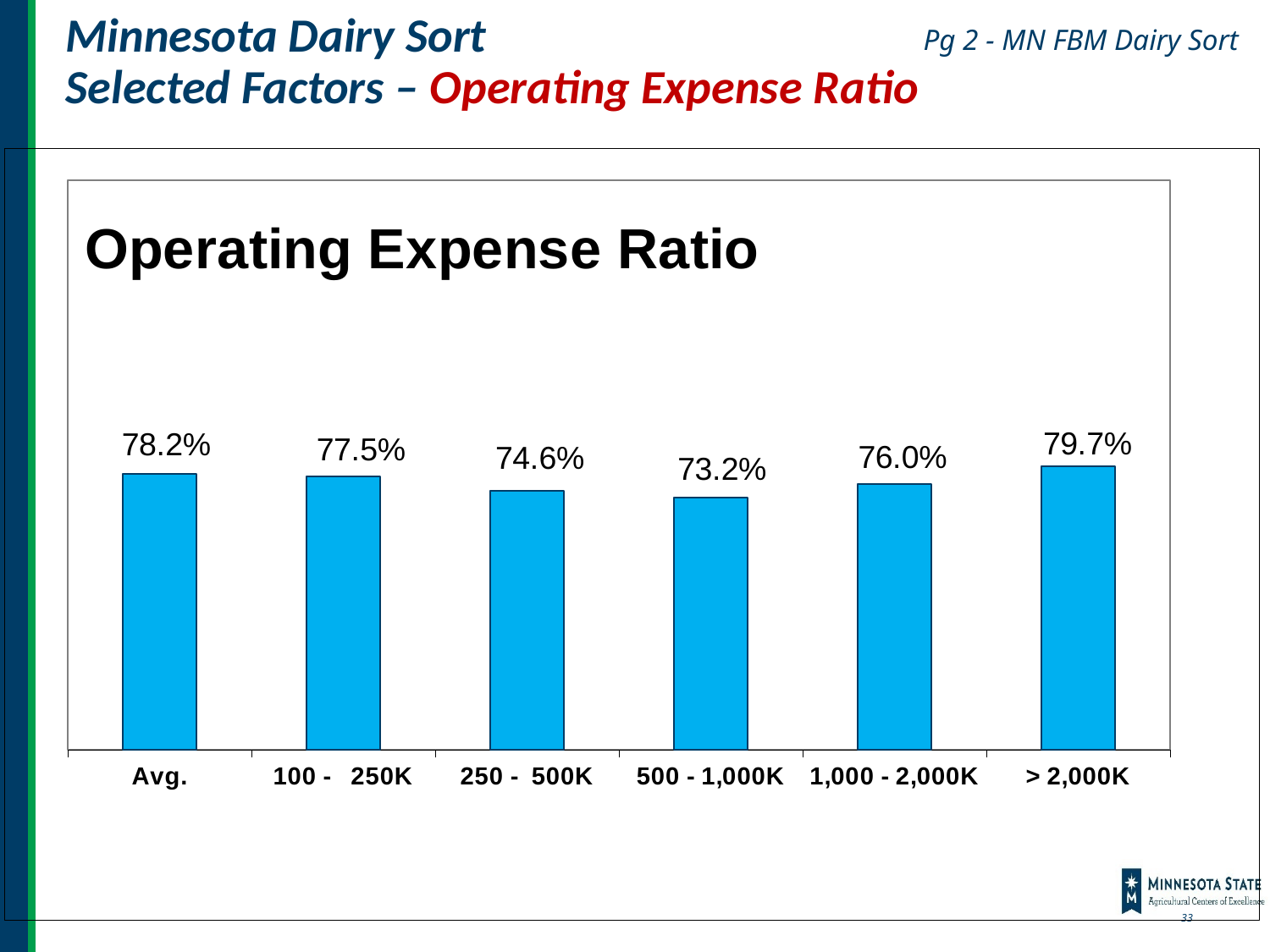
What is the Operating Expense Ratio for the 500 - 1,000K category? 73.2% How many categories are shown on the x axis of the chart? 6 Which has a higher Operating Expense Ratio, 250 - 500K or 1,000 - 2,000K? 1,000 - 2,000K Which category has the lowest Operating Expense Ratio? 500 - 1,000K What is the Operating Expense Ratio for the Avg. category? 78.2% What is the Operating Expense Ratio for the > 2,000K category? 79.7% What is the title of the chart? Operating Expense Ratio Which category has the highest Operating Expense Ratio? > 2,000K What is the difference between the Operating Expense Ratio for > 2,000K and for 500 - 1,000K? 6.5% What is the Operating Expense Ratio for the 1,000 - 2,000K category? 76.0% What is the difference between the Operating Expense Ratio for Avg. and for 100 - 250K? 0.7% What kind of chart is shown on the slide? Bar chart